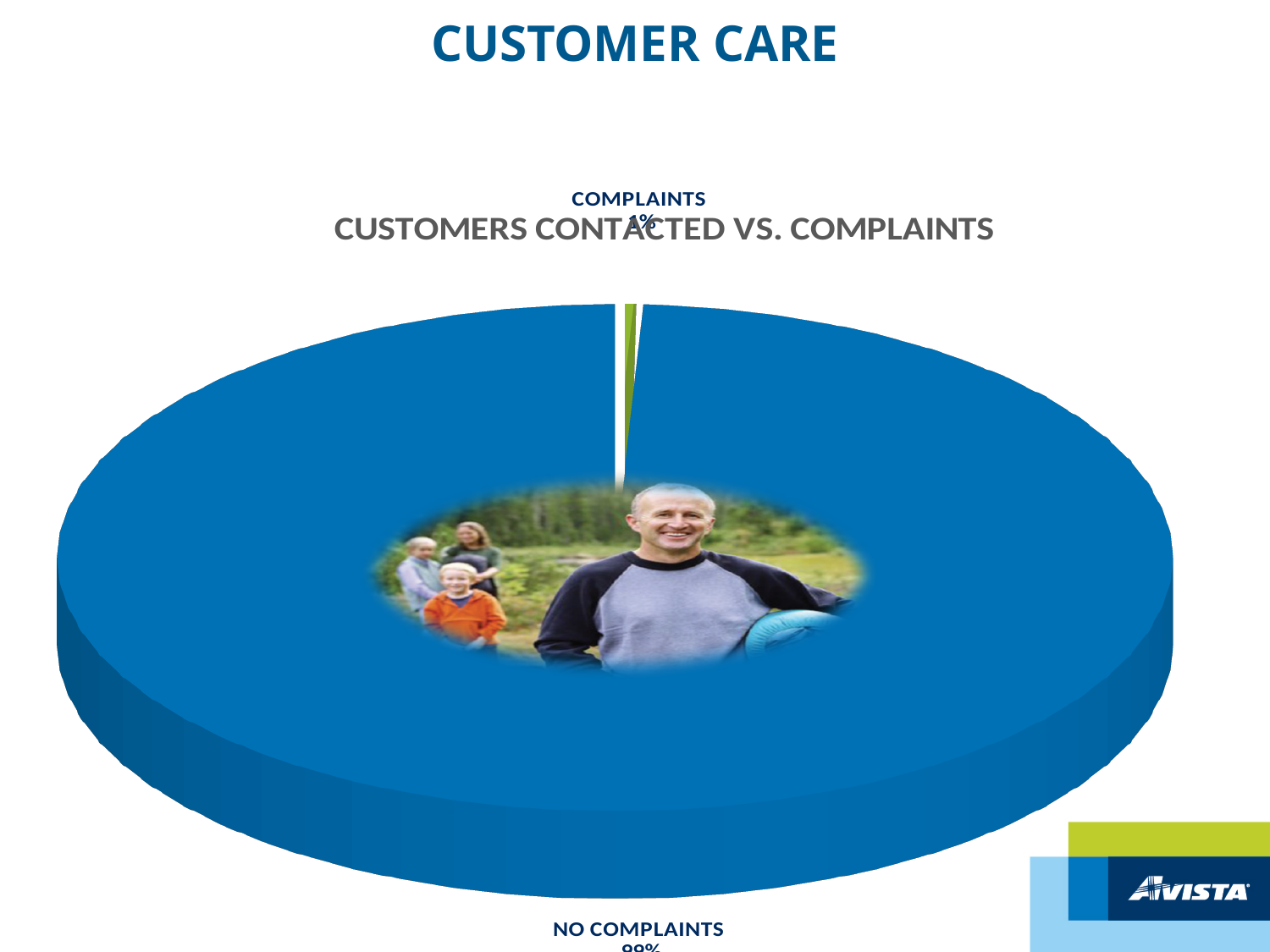
Is the share for COMPLAINTS greater or less than 50%? less How many slices does the pie chart have? 2 What kind of chart is shown on the slide? pie chart Which slice is the smallest in the pie chart? COMPLAINTS Which is larger, the NO COMPLAINTS slice or the COMPLAINTS slice? NO COMPLAINTS Is the share for NO COMPLAINTS greater or less than 50%? greater What colour is the NO COMPLAINTS slice? blue What is the title of the chart? CUSTOMERS CONTACTED VS. COMPLAINTS Which slice is the largest in the pie chart? NO COMPLAINTS What share of the pie does the COMPLAINTS slice represent? 1%